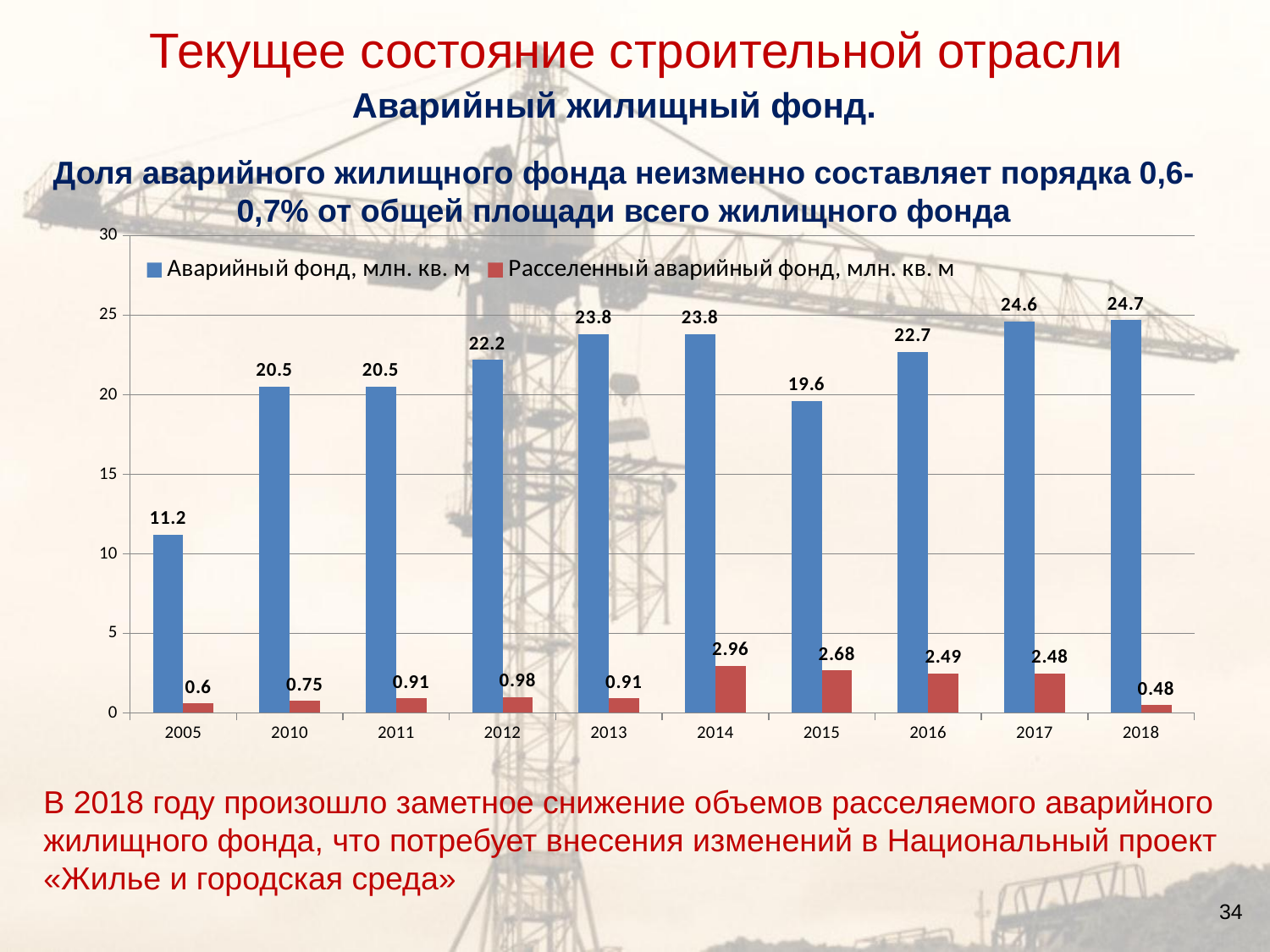
Is the value of "Аварийный фонд, млн. кв. м" for 2015 greater or less than 20? less How many years are shown on the x axis of the chart? 10 Which year has the lowest value for "Расселенный аварийный фонд, млн. кв. м"? 2018 What kind of chart is shown on the slide? Bar chart Which year has the highest value for "Аварийный фонд, млн. кв. м"? 2018 What is the value of "Расселенный аварийный фонд, млн. кв. м" for 2014? 2.96 What is the value of "Аварийный фонд, млн. кв. м" for 2005? 11.2 Which colour represents "Расселенный аварийный фонд, млн. кв. м" in the chart? Red What is the value of "Аварийный фонд, млн. кв. м" for 2018? 24.7 Which is larger: the "Расселенный аварийный фонд, млн. кв. м" value for 2015 or for 2016? 2015 How many series does the chart legend list? 2 What is the difference between the "Аварийный фонд, млн. кв. м" values for 2018 and 2005? 13.5